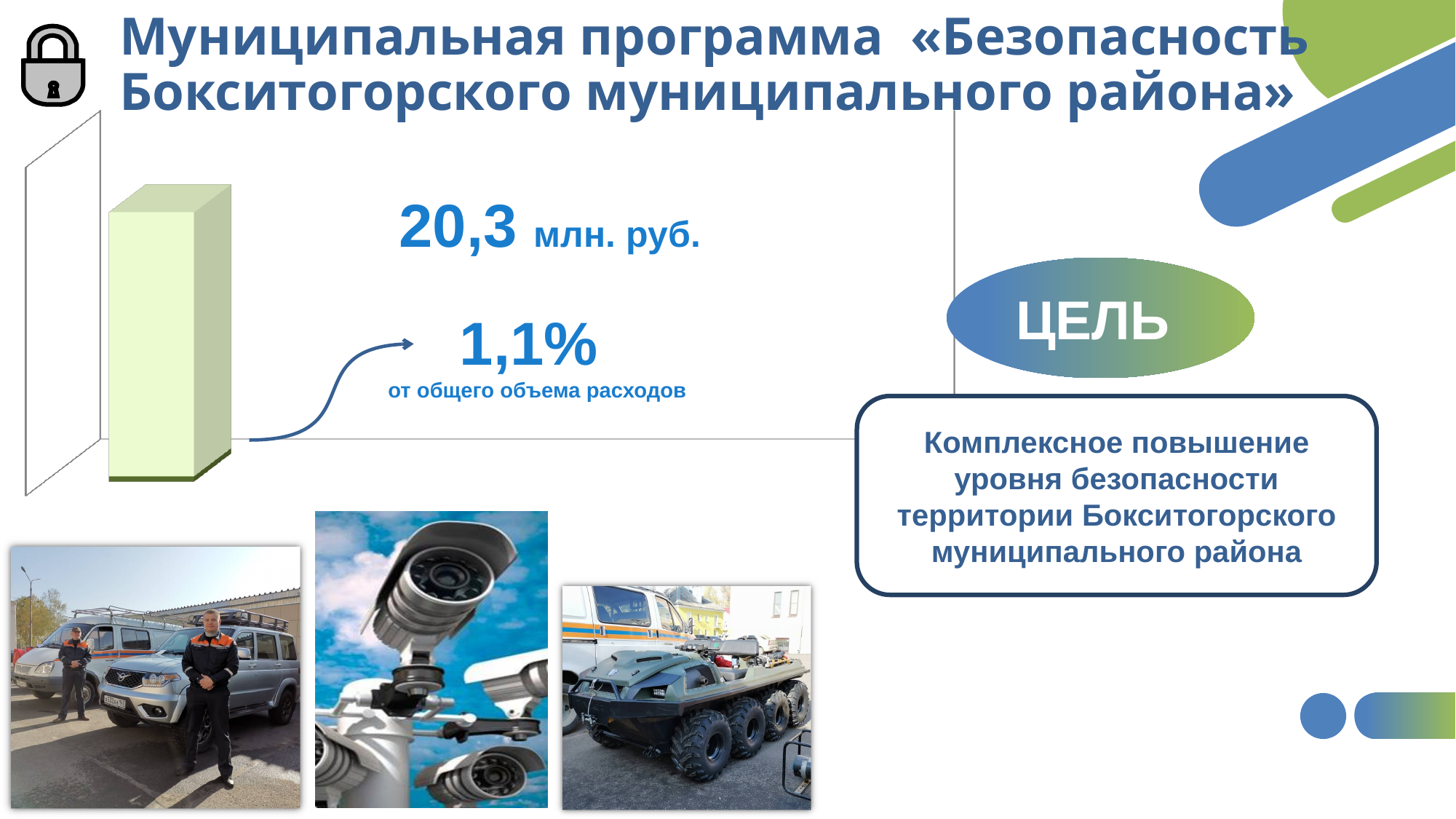
What text appears under the 1,1% label next to the bar? от общего объема расходов What colour is the bar in the chart on the left of the slide? light green What amount in million rubles is shown next to the bar on the slide? 20,3 млн. руб. How many bars does the chart on the left of the slide contain? 1 What kind of chart is shown on the left of the slide? bar chart What percentage of total expenditure does the bar on the slide represent, according to the label with the arrow? 1,1%